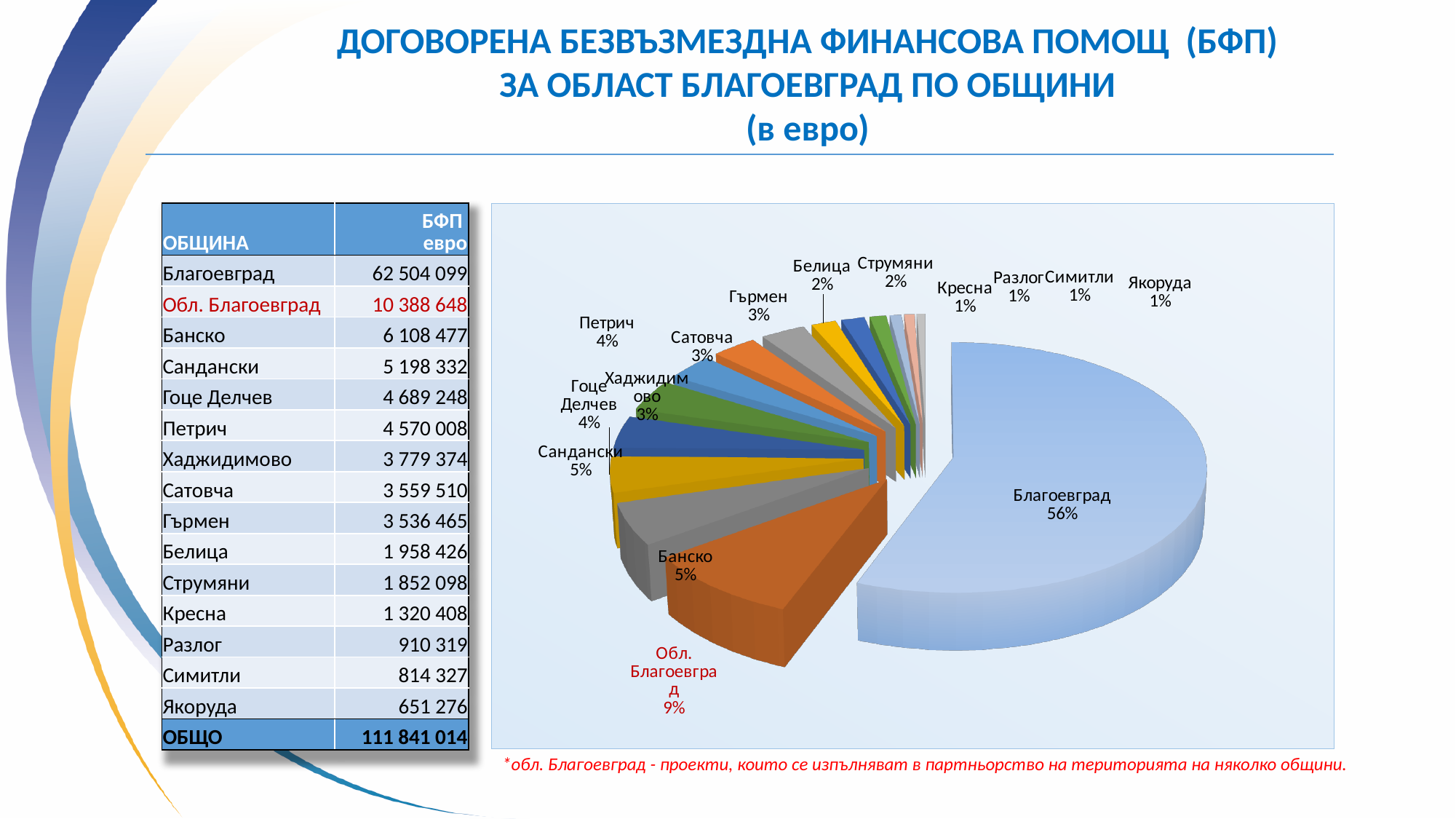
What is the difference in percentage points between the Благоевград slice and the Обл. Благоевград slice? 47% What kind of chart is shown on the slide? pie chart Which slice of the pie chart is the largest? Благоевград How many slices does the pie chart have? 15 What share of the pie does Белица have? 2% Which slice label in the pie chart is written in red? Обл. Благоевград What share of the pie does Банско have? 5% What share of the pie does Якоруда have? 1% Which slice is larger, Сандански or Гърмен? Сандански